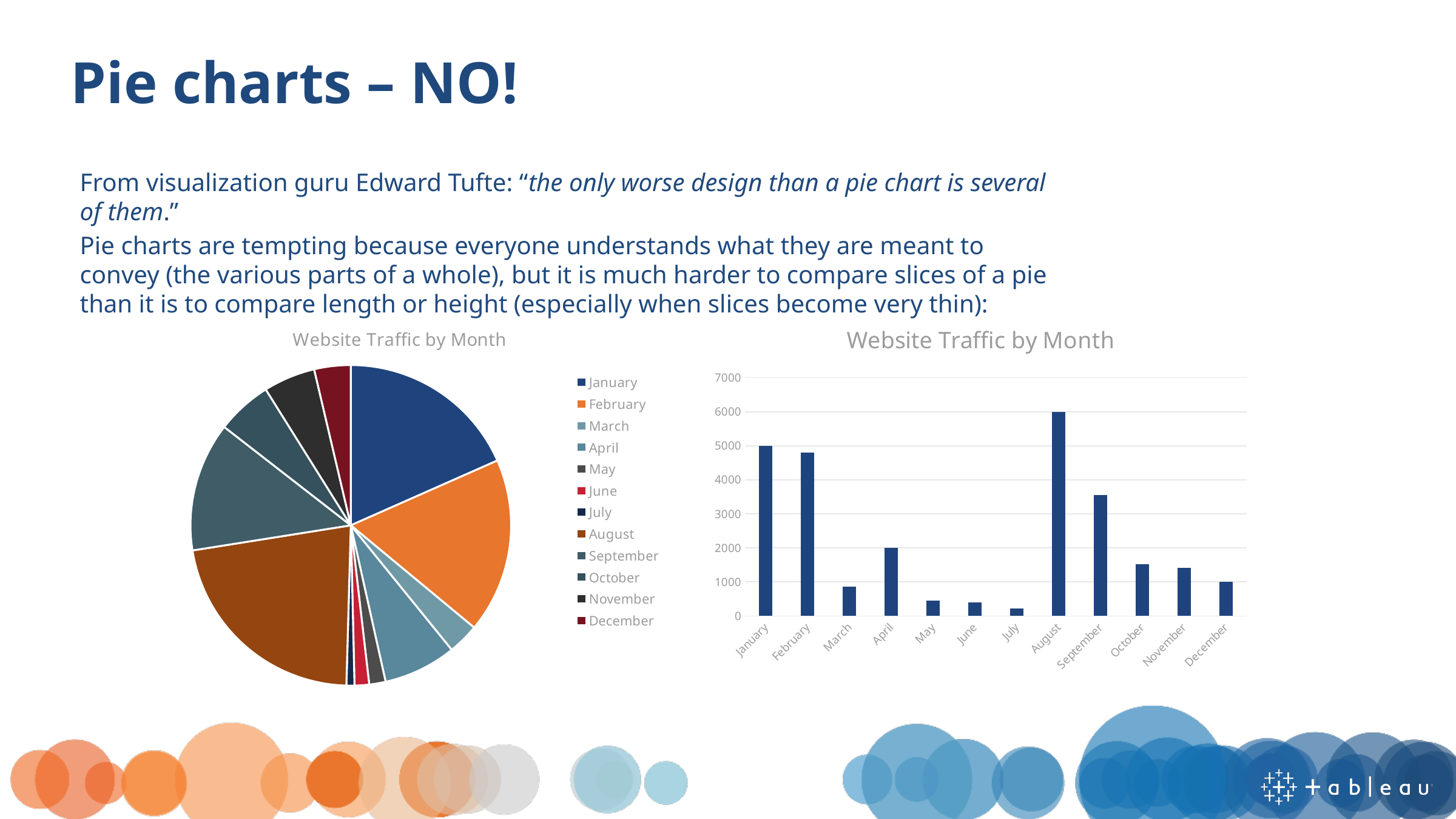
On the bar chart on the right, is the value for March greater or less than 1000? less On the bar chart on the right, what is the value for April? 2000 On the bar chart on the right, which month has the lowest website traffic? July On the bar chart on the right, which month has the highest website traffic? August On the bar chart on the right, what is the value for August? 6000 How many months are shown on the bar chart on the right? 12 On the bar chart on the right, which is larger, the value for September or the value for April? September What kind of chart is the chart on the left of the slide? Pie chart On the bar chart on the right, is the value for September greater or less than 3000? greater On the pie chart on the left, which month has the largest slice? August How many entries does the legend of the pie chart on the left list? 12 On the bar chart on the right, is the value for February greater or less than 4000? greater